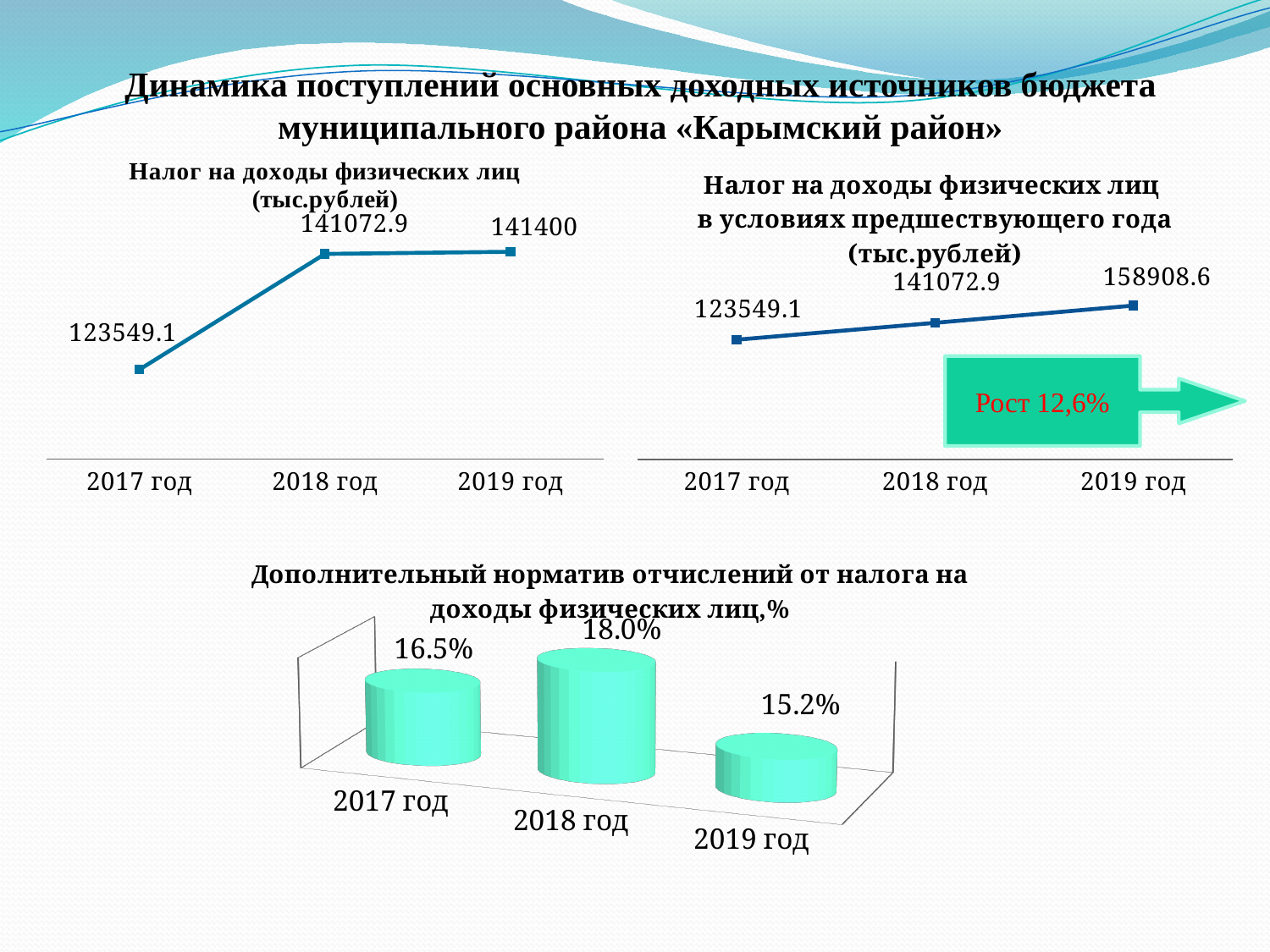
In the top-left chart 'Налог на доходы физических лиц (тыс.рублей)', what kind of chart is shown? Line chart In the top-right chart 'Налог на доходы физических лиц в условиях предшествующего года (тыс.рублей)', what is the value for 2019 год? 158908.6 In the bottom chart 'Дополнительный норматив отчислений от налога на доходы физических лиц,%', what is the value for 2018 год? 18.0% In the top-right chart 'Налог на доходы физических лиц в условиях предшествующего года (тыс.рублей)', what is the difference between the 2019 год and 2018 год values? 17835.7 In the bottom chart 'Дополнительный норматив отчислений от налога на доходы физических лиц,%', how many years are shown? 3 In the top-right chart 'Налог на доходы физических лиц в условиях предшествующего года (тыс.рублей)', which year has the lowest value? 2017 год In the bottom chart 'Дополнительный норматив отчислений от налога на доходы физических лиц,%', what kind of chart is shown? Bar chart In the bottom chart 'Дополнительный норматив отчислений от налога на доходы физических лиц,%', which year has the lowest value? 2019 год In the top-left chart 'Налог на доходы физических лиц (тыс.рублей)', what is the value for 2019 год? 141400 In the top-left chart 'Налог на доходы физических лиц (тыс.рублей)', what is the difference between the 2018 год and 2017 год values? 17523.8 In the top-right chart 'Налог на доходы физических лиц в условиях предшествующего года (тыс.рублей)', do the values rise or fall from 2017 год to 2019 год? Rise In the top-left chart 'Налог на доходы физических лиц (тыс.рублей)', what is the value for 2017 год? 123549.1